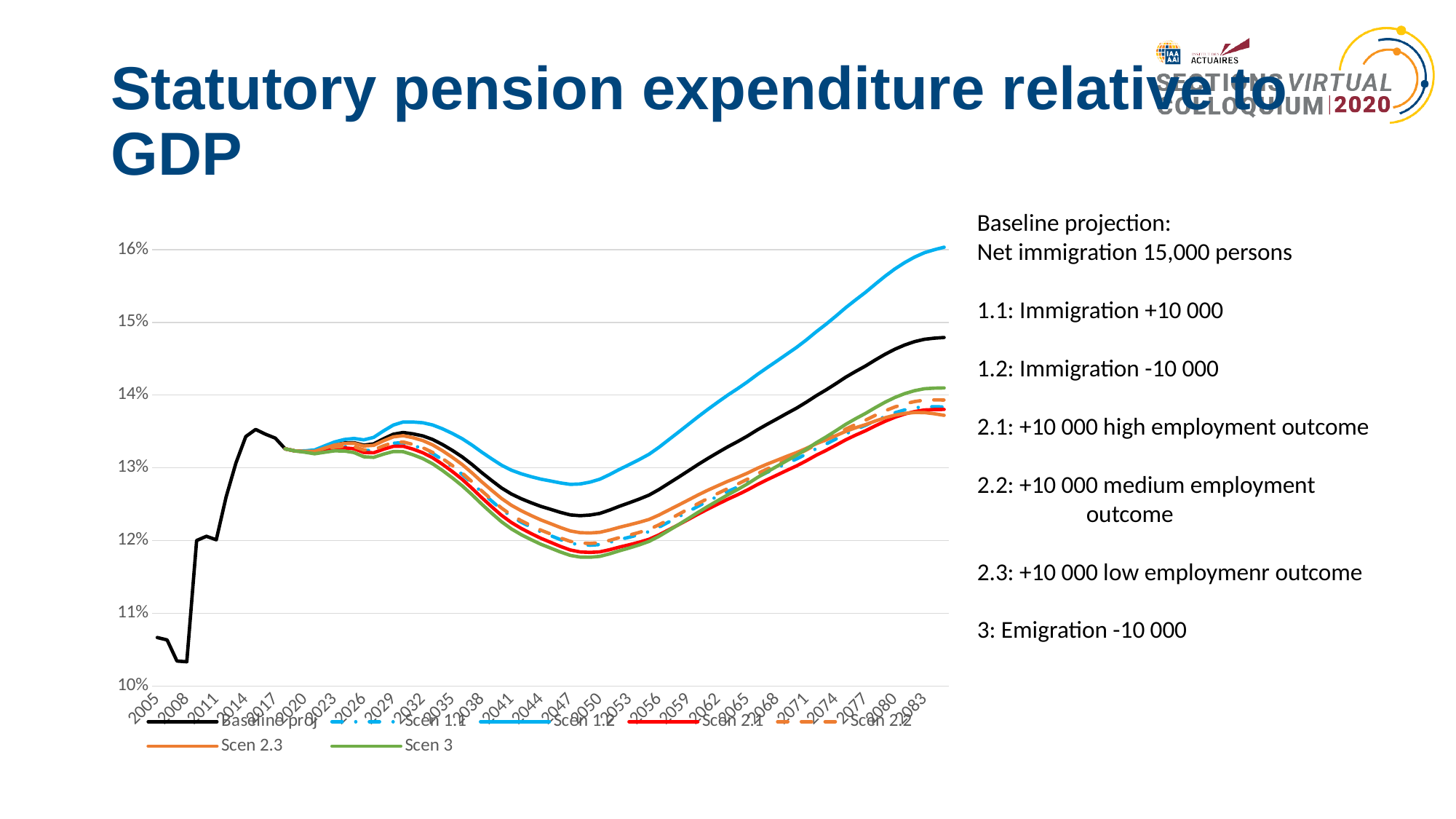
What is the title of the slide containing the chart? Statutory pension expenditure relative to GDP At 2083, which is larger: Scen 1.2 or Baseline proj? Scen 1.2 Which series is highest at the right end of the chart (around 2083)? Scen 1.2 At 2083, which is larger: Baseline proj or Scen 3? Baseline proj How many series does the chart legend list? 7 Does the Baseline proj series rise or fall between 2050 and 2083? rise Which series is highest around 2050? Scen 1.2 Is the value for Scen 1.2 at 2083 greater or less than 15%? greater Is the value for Baseline proj around 2050 greater or less than 13%? less Is the value for Baseline proj at 2005 greater or less than 11%? less What kind of chart is shown on the slide? line chart